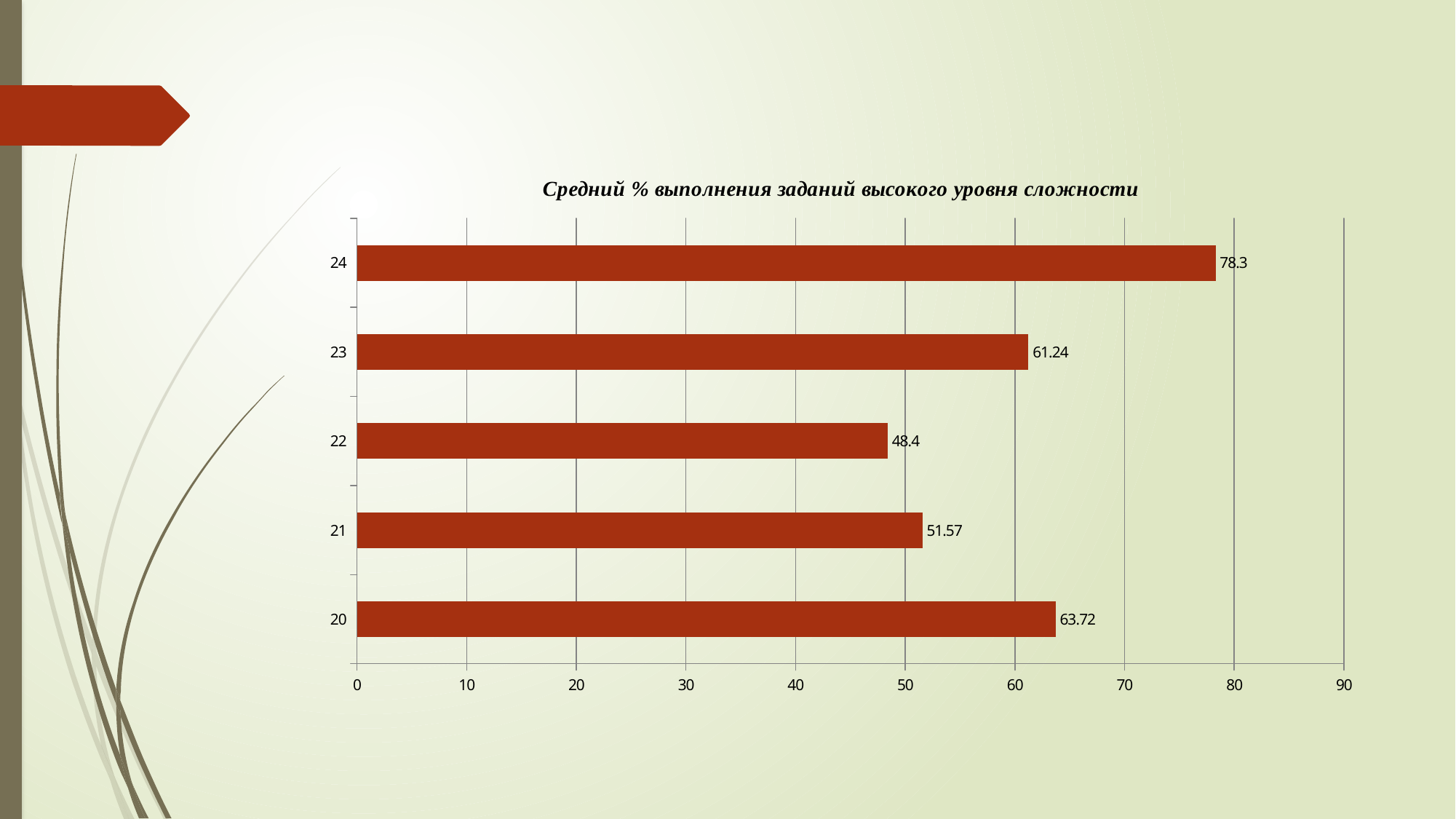
What is the difference between the values for category 20 and category 21? 12.15 How many categories are shown in the chart? 5 What kind of chart is shown on the slide? bar chart Which category has the lowest value? 22 Which category has the highest value? 24 What is the difference between the values for category 24 and category 23? 17.06 What is the title of the chart? Средний % выполнения заданий высокого уровня сложности What is the value for category 24? 78.3 What is the value for category 20? 63.72 What is the value for category 22? 48.4 Is the value for category 21 greater or less than 50? greater Which is larger, the value for category 23 or the value for category 20? 20